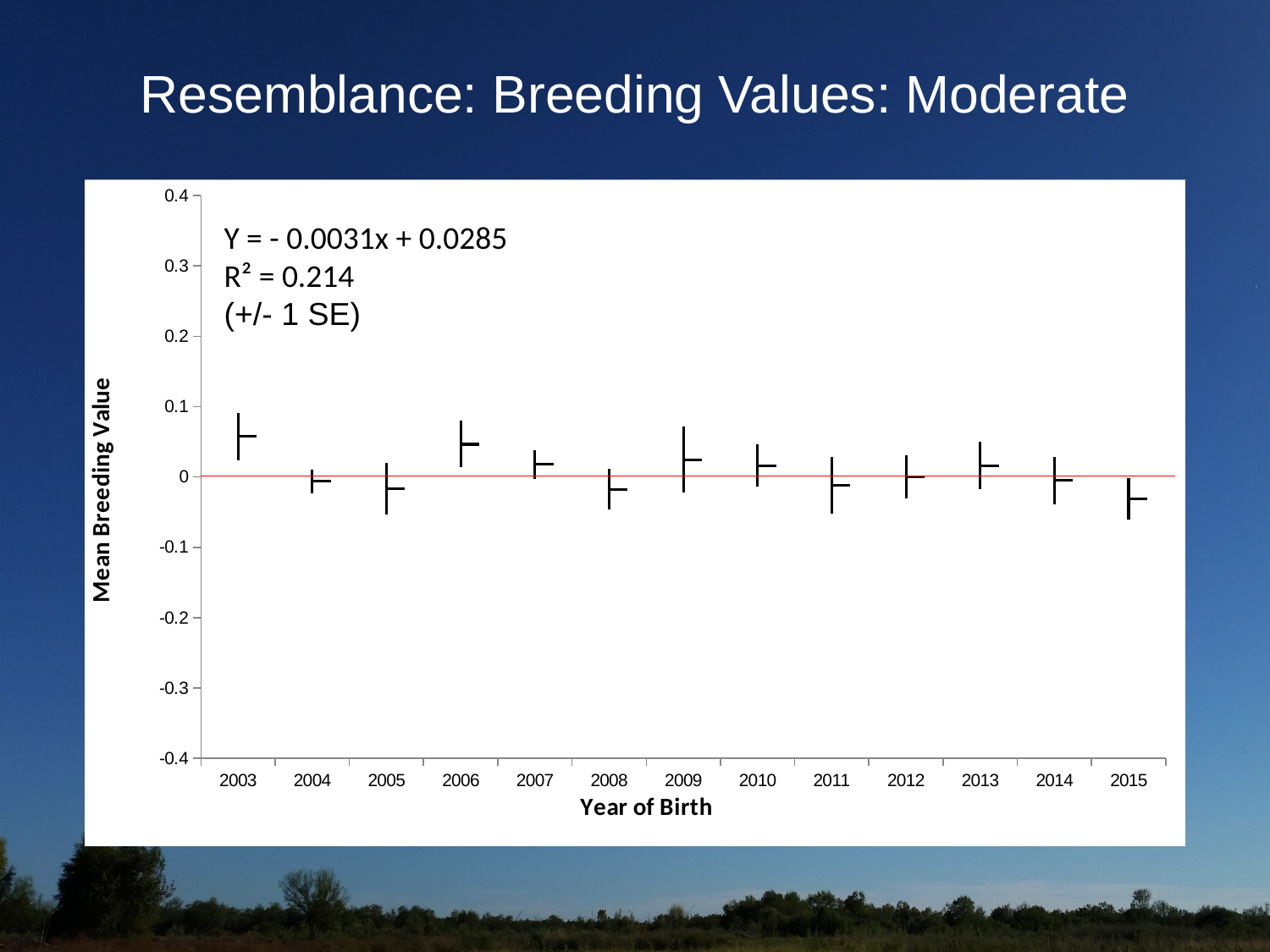
What is the title of the slide containing the chart? Resemblance: Breeding Values: Moderate What is the R² value shown on the chart? 0.214 Is the mean breeding value for 2003 greater or less than 0? greater Is the mean breeding value for 2005 greater or less than 0? less Is the mean breeding value for 2006 greater or less than 0? greater According to the fitted trend line equation, do mean breeding values rise or fall across years of birth? fall Which year has the larger mean breeding value, 2006 or 2005? 2006 How many years of birth are plotted on the x axis? 13 Which year has the larger mean breeding value, 2003 or 2015? 2003